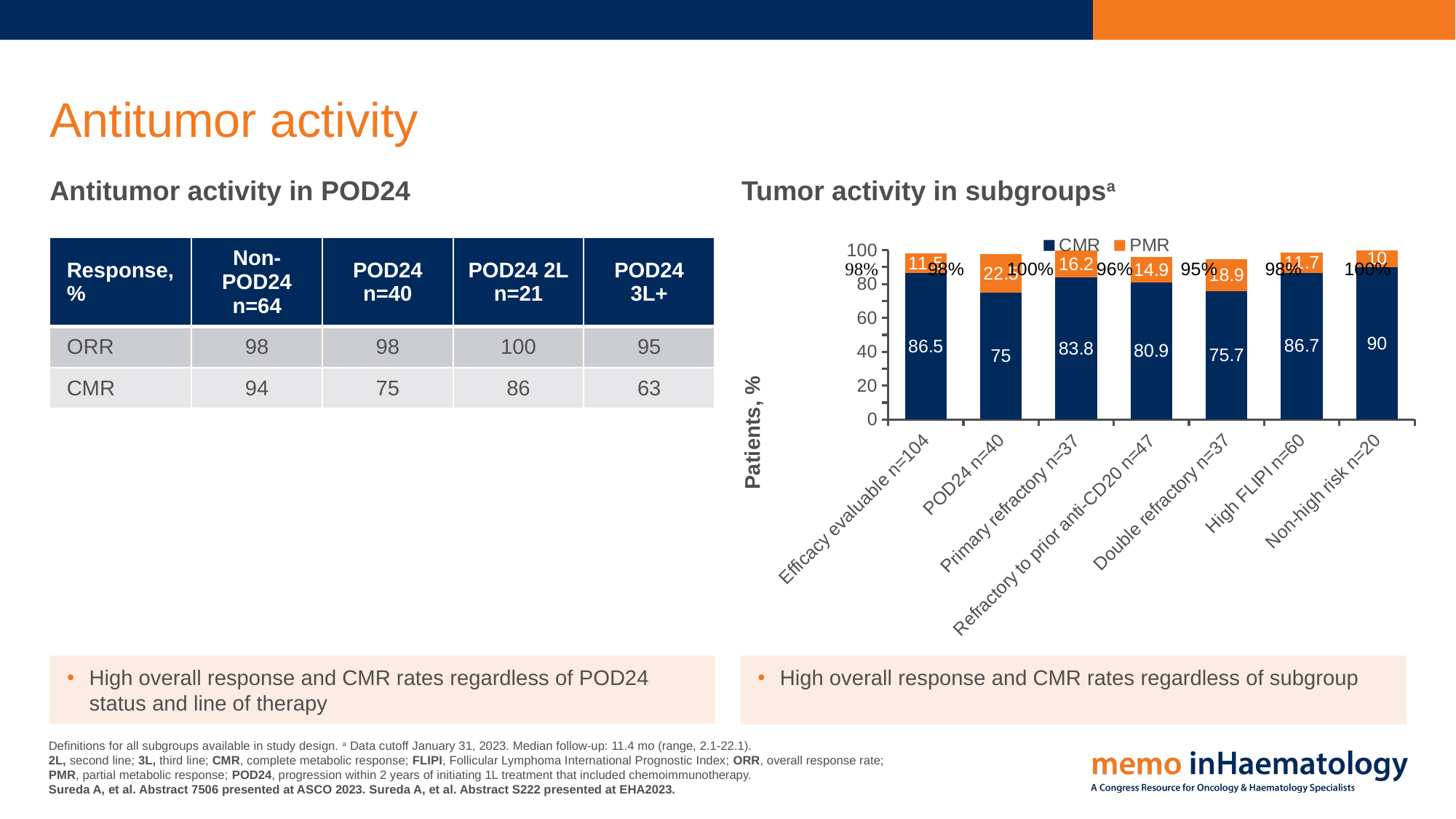
What kind of chart is shown under "Tumor activity in subgroups"? Stacked bar chart In the "Tumor activity in subgroups" chart, which has the larger CMR value: Efficacy evaluable n=104 or Double refractory n=37? Efficacy evaluable n=104 In the "Tumor activity in subgroups" chart, what is the CMR value for Non-high risk n=20? 90 In the "Tumor activity in subgroups" chart, what is the PMR value for Primary refractory n=37? 16.2 In the "Tumor activity in subgroups" chart, which subgroup has the highest CMR value? Non-high risk n=20 In the "Tumor activity in subgroups" chart, what is the label of the y axis? Patients, % How many subgroups are plotted on the x axis of the "Tumor activity in subgroups" chart? 7 How many series does the legend of the "Tumor activity in subgroups" chart list? 2 In the "Tumor activity in subgroups" chart, which subgroup has the lowest PMR value? Non-high risk n=20 In the "Tumor activity in subgroups" chart, what is the CMR value for Refractory to prior anti-CD20 n=47? 80.9 In the "Tumor activity in subgroups" chart, what is the total of the stacked bar for Primary refractory n=37 (CMR plus PMR)? 100 In the "Tumor activity in subgroups" chart, what is the difference between the CMR value for Non-high risk n=20 and the CMR value for POD24 n=40? 15